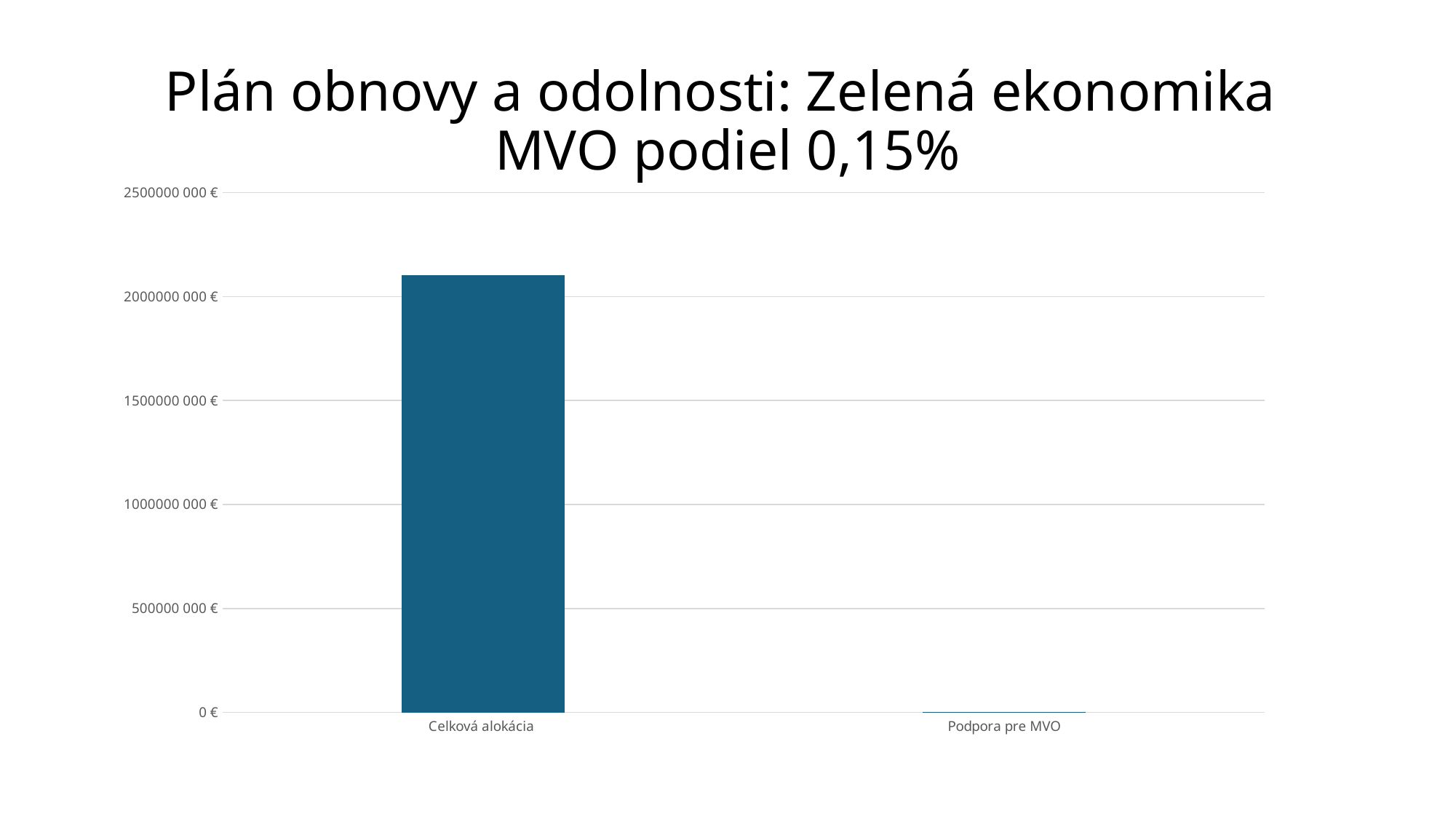
Is the value for Celková alokácia greater or less than 2500000 000 €? less Which category has the highest value? Celková alokácia What kind of chart is shown on the slide? bar chart Is the value for Celková alokácia greater or less than 1500000 000 €? greater What is the title of the chart on the slide? Plán obnovy a odolnosti: Zelená ekonomika MVO podiel 0,15% Which is larger, the value for Celková alokácia or the value for Podpora pre MVO? Celková alokácia Is the value for Celková alokácia greater or less than 2000000 000 €? greater Which category has the lowest value? Podpora pre MVO What is the highest value shown on the vertical axis? 2500000 000 € How many categories are plotted on the chart? 2